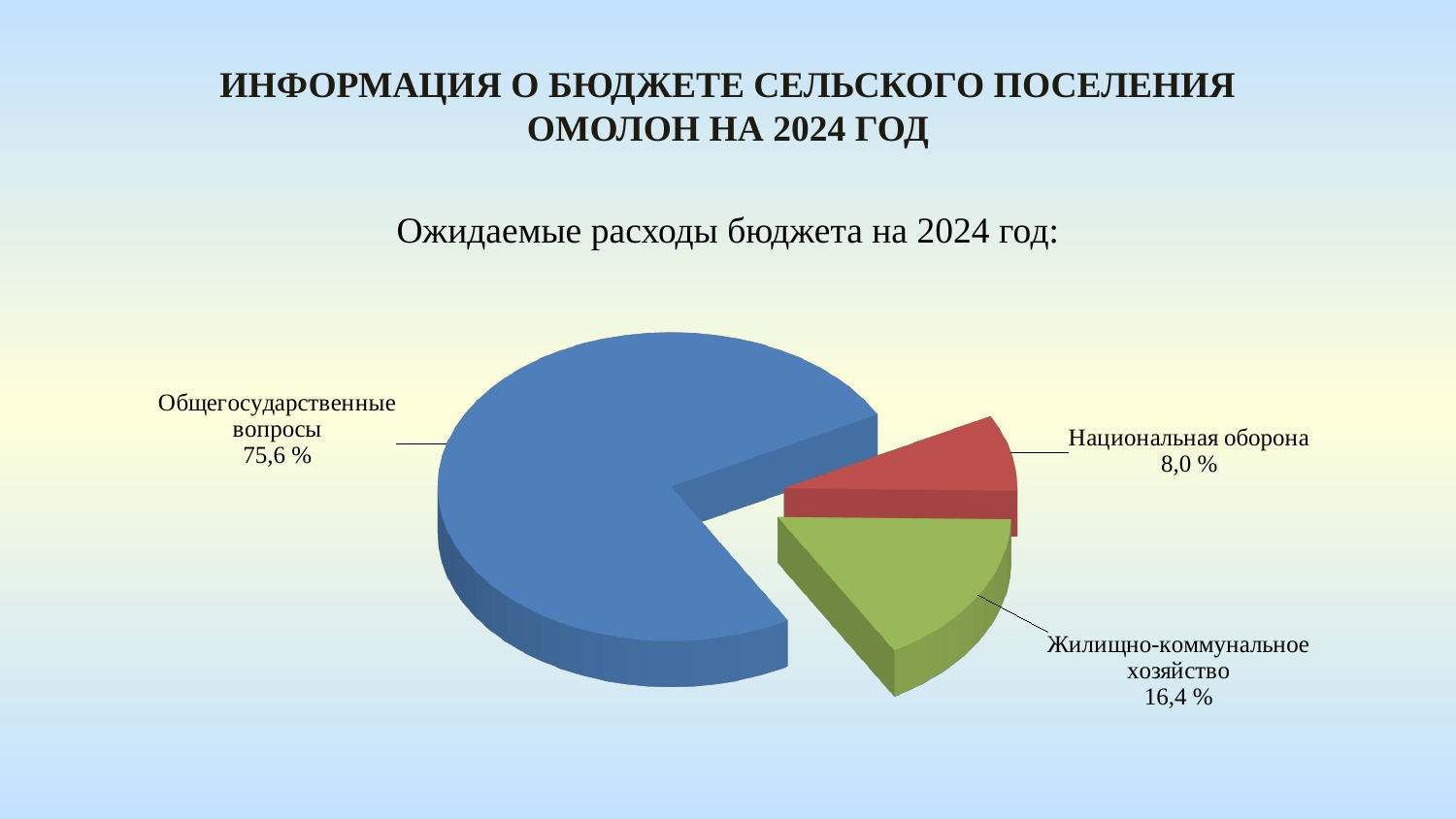
Which is larger: the share for Жилищно-коммунальное хозяйство or the share for Национальная оборона? Жилищно-коммунальное хозяйство What colour is the slice for Общегосударственные вопросы? blue Which category has the largest share of the pie? Общегосударственные вопросы What share of the expected 2024 budget expenses goes to Жилищно-коммунальное хозяйство? 16,4 % What is the difference in percentage points between Жилищно-коммунальное хозяйство and Национальная оборона? 8,4 What kind of chart is shown on the slide? pie chart How many categories (slices) does the pie chart show? 3 Which category has the smallest share of the pie? Национальная оборона What share of the expected 2024 budget expenses goes to Национальная оборона? 8,0 % What is the difference in percentage points between Общегосударственные вопросы and Жилищно-коммунальное хозяйство? 59,2 What is the subtitle above the pie chart? Ожидаемые расходы бюджета на 2024 год: What share of the expected 2024 budget expenses goes to Общегосударственные вопросы? 75,6 %